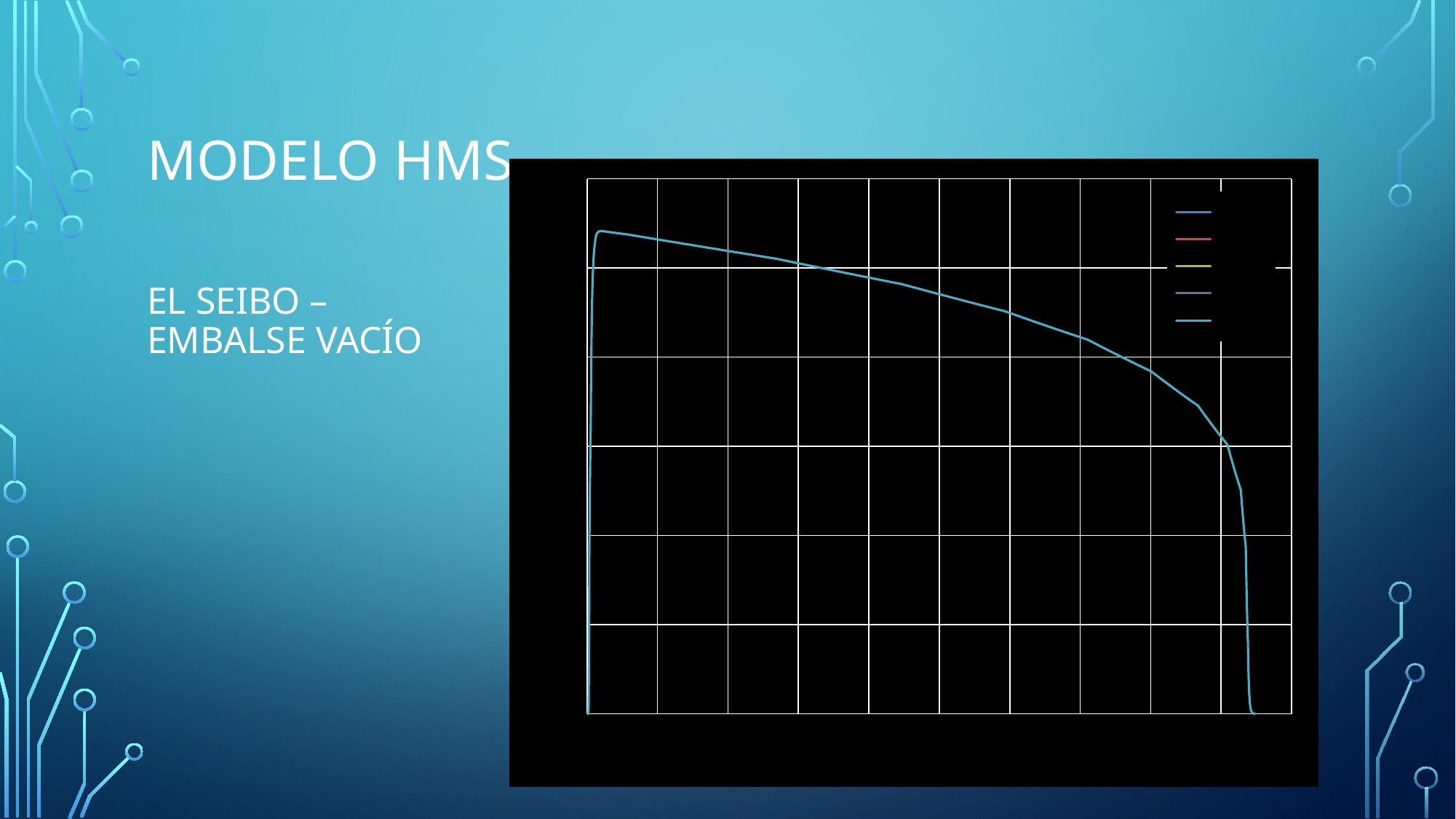
What is the background colour of the chart area? black What kind of chart is shown on the slide? line chart How many colour entries does the legend in the top-right corner of the chart show? 5 After its initial sharp rise at the left edge, does the plotted line rise or fall as it moves to the right along the x axis? fall How many lines are actually plotted on the chart? 1 What colour is the plotted line on the chart? light blue